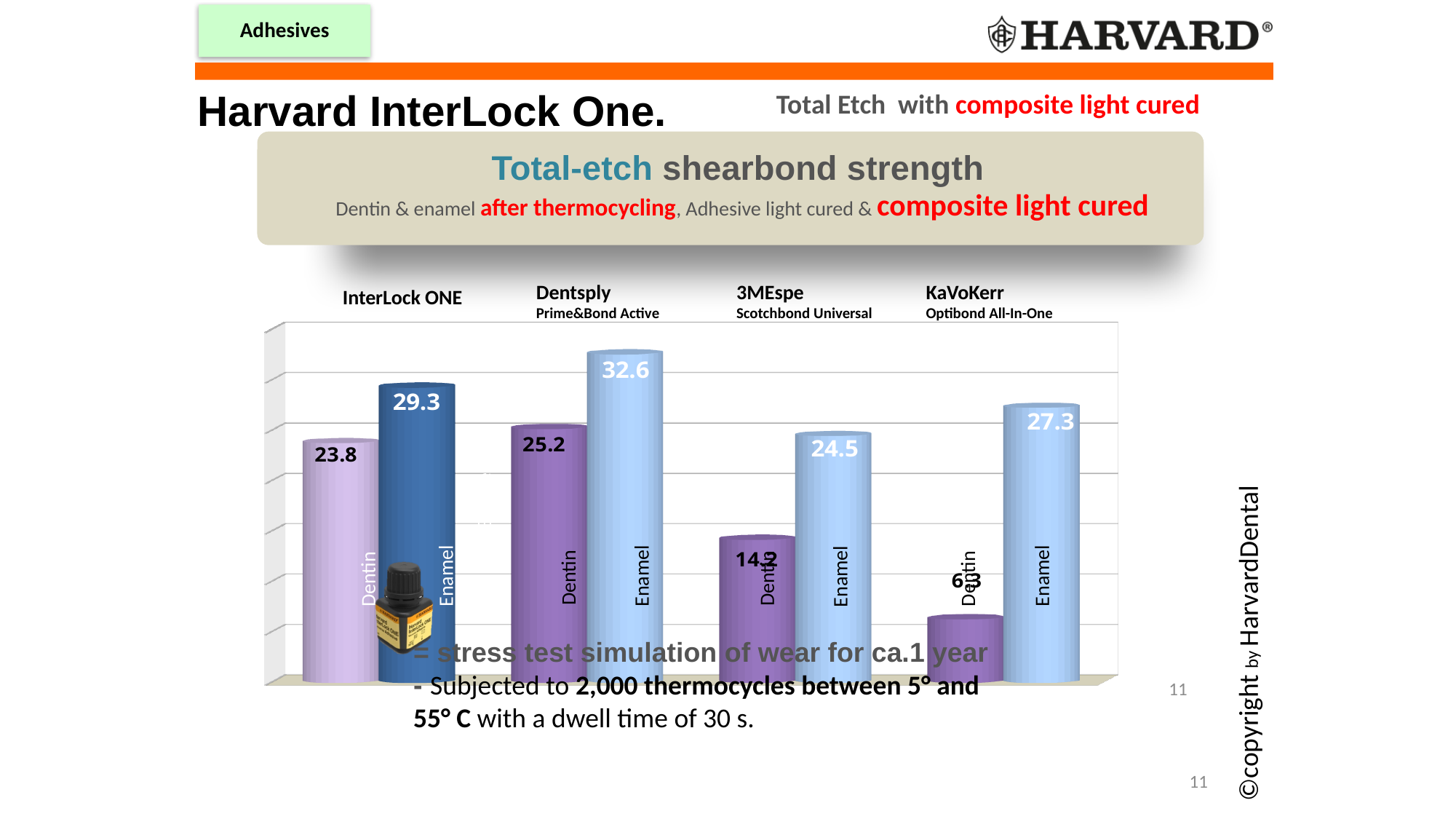
Which product has the highest Enamel shear bond strength? Dentsply Prime&Bond Active What is the Dentin value shown for Dentsply Prime&Bond Active? 25.2 Which product has the lowest Dentin shear bond strength? KaVoKerr Optibond All-In-One What is the difference between the Enamel and Dentin values for InterLock ONE? 5.5 How many adhesive products are compared in the chart? 4 What is the Enamel value shown for KaVoKerr Optibond All-In-One? 27.3 What is the Enamel value shown for Dentsply Prime&Bond Active? 32.6 What is the Enamel value shown for 3MEspe Scotchbond Universal? 24.5 What kind of chart is shown on the slide? Bar chart What is the Enamel value shown for InterLock ONE? 29.3 What is the Dentin shear bond strength value shown for InterLock ONE? 23.8 Which has a higher Dentin value: InterLock ONE or Dentsply Prime&Bond Active? Dentsply Prime&Bond Active